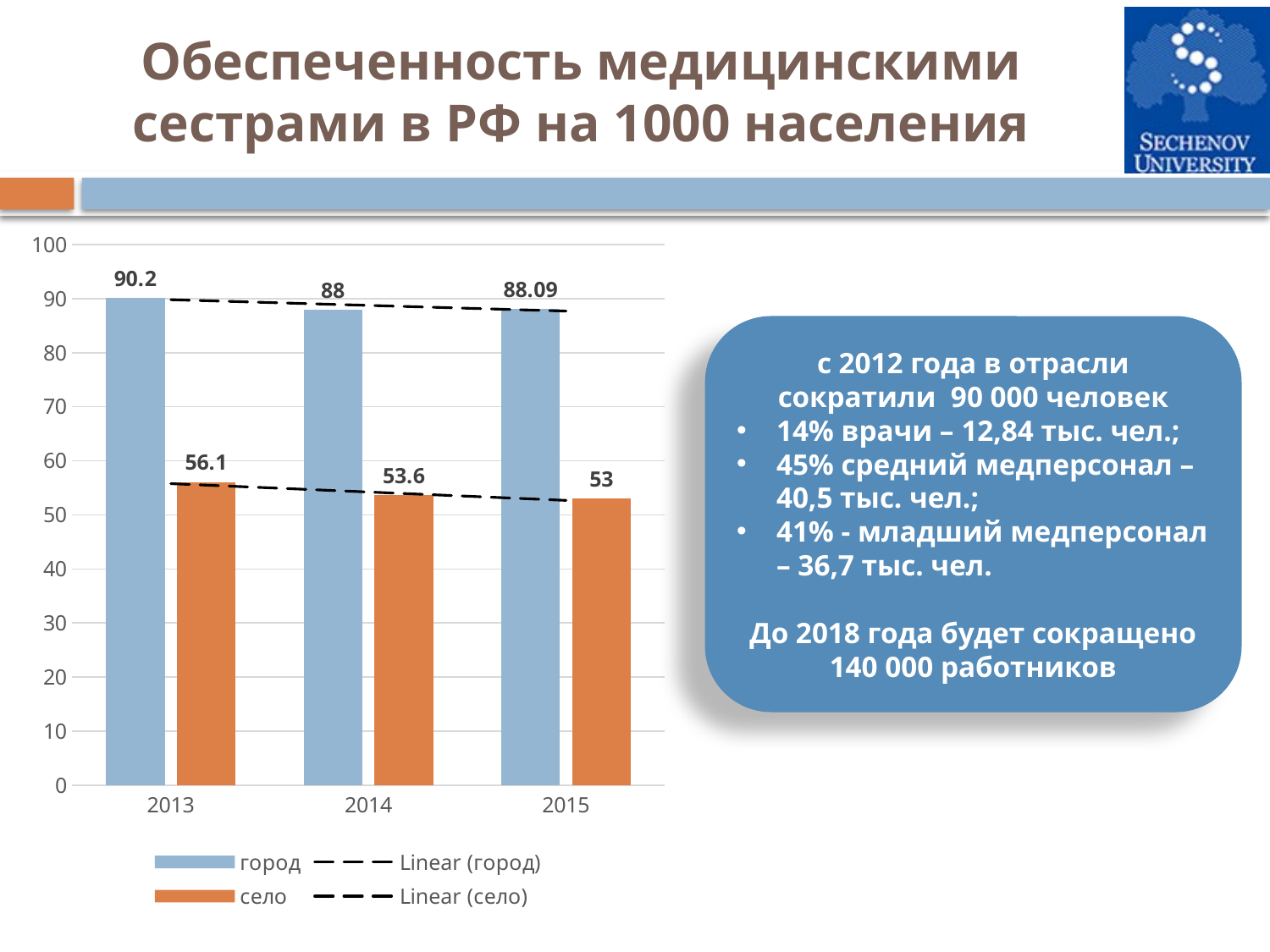
What is the value for село in 2014? 53.6 What is the value for город in 2013? 90.2 In which year is the value for город highest? 2013 Which is larger in 2014, the value for город or for село? город In which year is the value for село lowest? 2015 How many entries does the legend list? 4 What is the difference between the город and село values in 2013? 34.1 By how much did the село value fall from 2013 to 2015? 3.1 What is the value for село in 2015? 53 Do the село values rise or fall from 2013 to 2015? fall How many years are shown on the x axis? 3 What is the value for город in 2015? 88.09